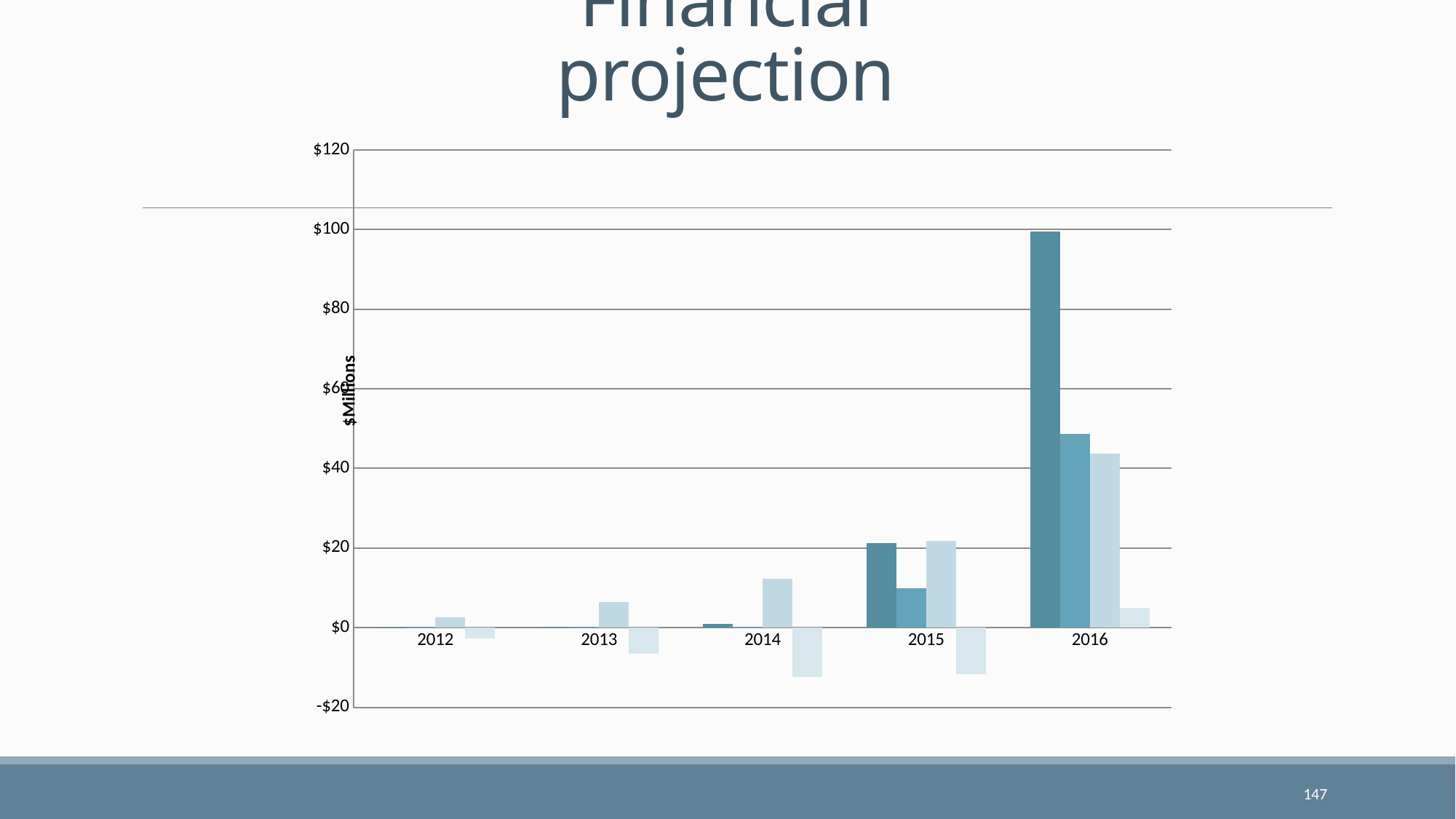
Do the values of the darkest bars rise or fall from 2012 to 2016? rise Is the value of the darkest bar for 2015 greater or less than $40? less What is the title of the slide containing the chart? Financial projection Is the value of the lightest (fourth) bar for 2014 greater or less than $0? less How many years are shown on the x axis of the chart? 5 Is the value of the darkest bar for 2016 greater or less than $80? greater In 2016, which is larger: the darkest (first) bar or the second bar? the darkest (first) bar What kind of chart is shown on the slide? bar chart How many bars are plotted for each year in the chart? 4 Which year has the tallest bar in the chart? 2016 What is the label on the vertical axis of the chart? $Millions